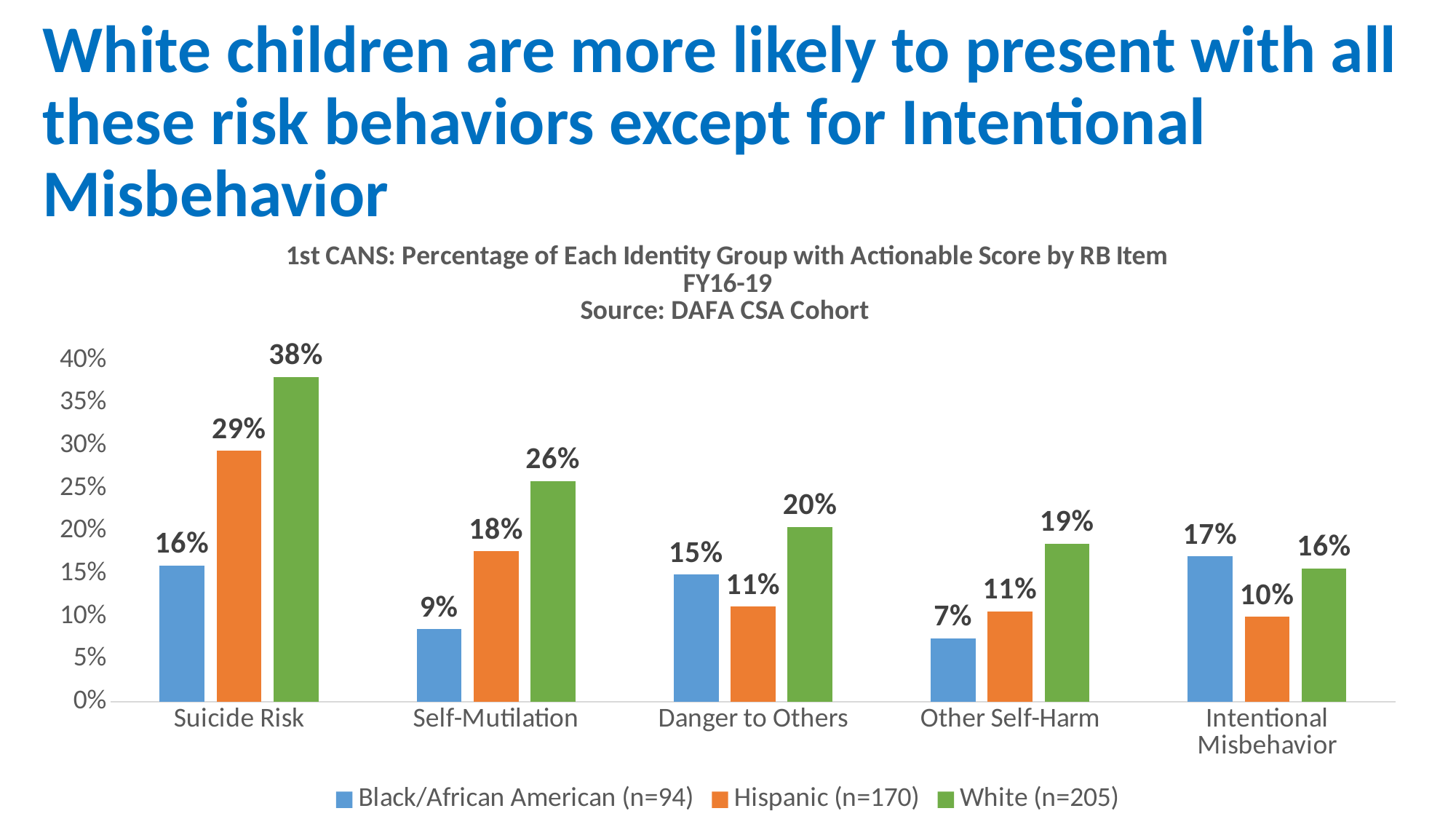
What is the difference between the White and Black/African American values for Suicide Risk? 22% How many risk behavior items are shown on the x axis? 5 Which risk behavior item has the highest value for White children? Suicide Risk What percentage of White children had an actionable score for Suicide Risk? 38% What kind of chart is shown on the slide? Bar chart For Intentional Misbehavior, which group has the larger value: Black/African American or White? Black/African American How many series does the legend list? 3 Which colour represents the White (n=205) series? Green What is the value for Hispanic children on Self-Mutilation? 18% What is the difference between the Hispanic and White values for Danger to Others? 9% Which identity group has the lowest value for Intentional Misbehavior? Hispanic (n=170) What percentage of Black/African American children had an actionable score for Other Self-Harm? 7%